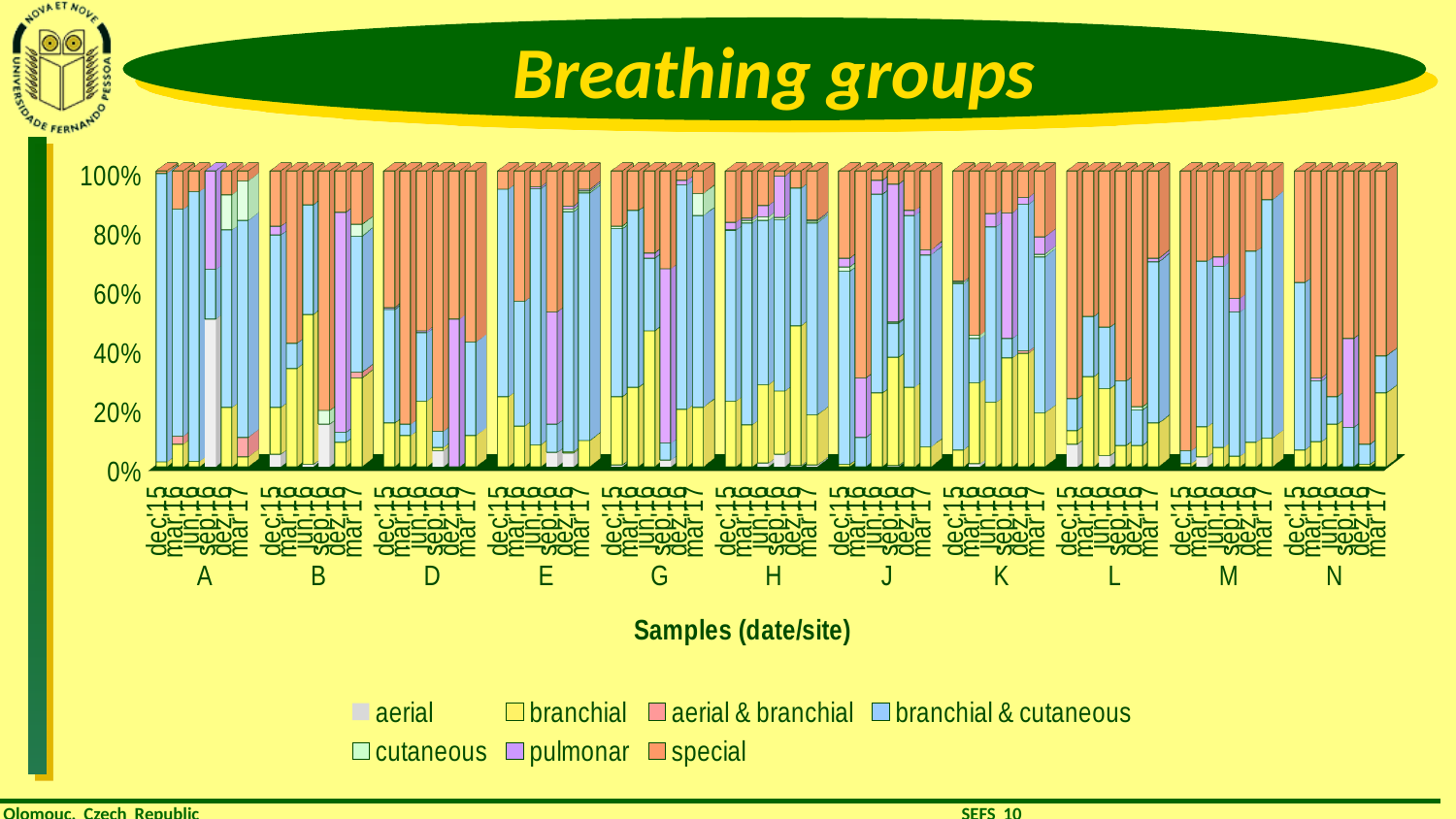
What kind of chart is shown on the slide? stacked bar chart Is the share of the 'special' group for site N in mar'17 greater or less than 50%? greater What is the title of the chart? Breathing groups Is the share of the 'special' group for site L in dec'15 greater or less than 50%? greater How many sites (A, B, D, ...) are shown along the x axis? 11 What is the label of the x axis? Samples (date/site) Is the share of the 'special' group for site A in dec'15 greater or less than 20%? less At which site does the 'aerial' group reach its largest share in any sample? A What is the highest value shown on the y axis? 100% How many breathing groups does the legend list? 7 How many sampling dates are shown for each site? 6